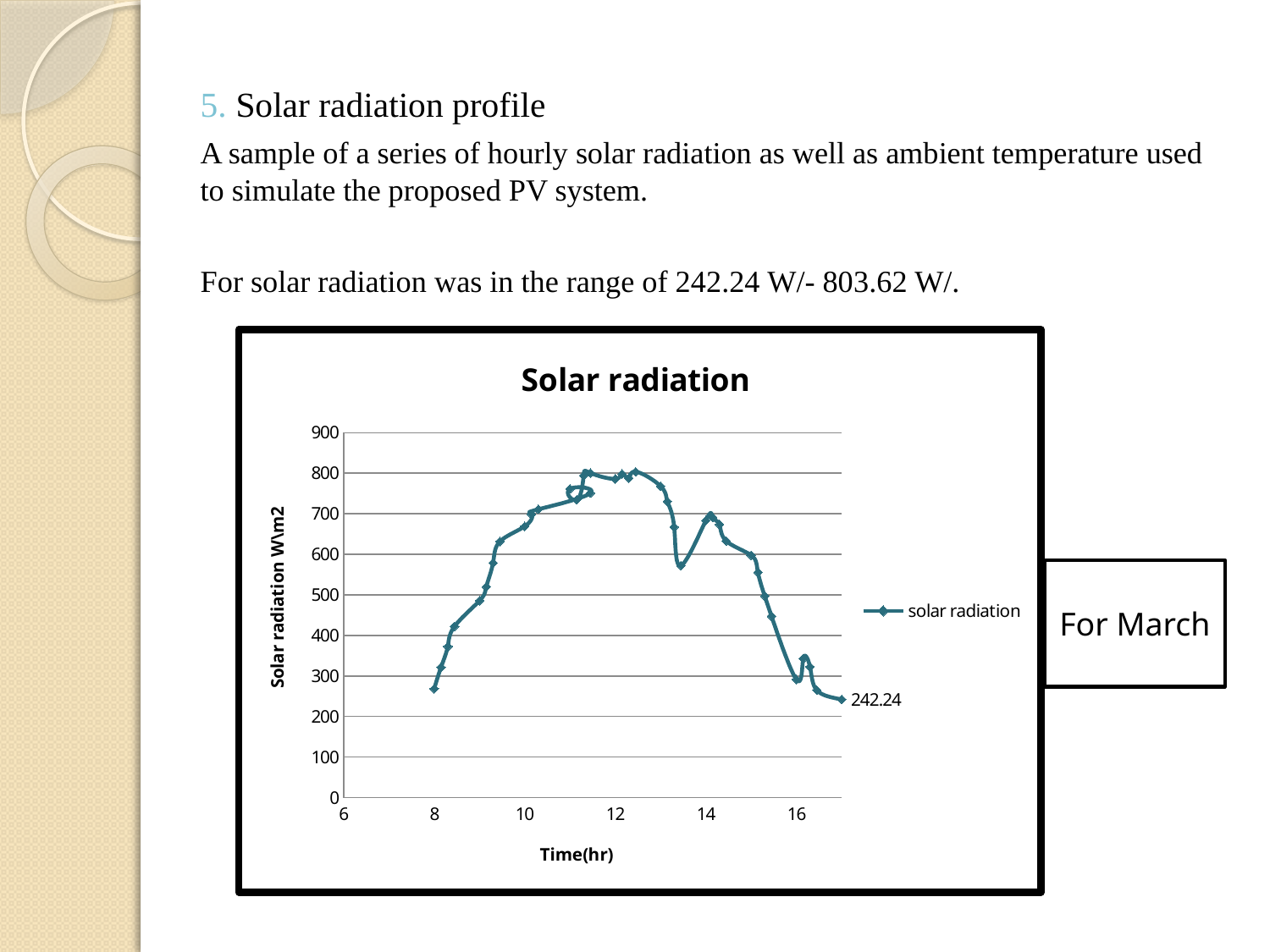
What is the lowest solar radiation value shown on the chart? 242.24 How many series does the legend list? 1 Does solar radiation rise or fall between 14 hr and 16 hr? fall Is the solar radiation value at 8 hr greater or less than 300? less What is the label of the x axis? Time(hr) What value is printed as a data label at the end of the solar radiation line? 242.24 Does solar radiation rise or fall between 8 hr and 12 hr? rise What is the title of the chart? Solar radiation What type of chart is shown on the slide? line chart Is the solar radiation value at 16 hr greater or less than 400? less Is the solar radiation value at 12 hr greater or less than 700? greater